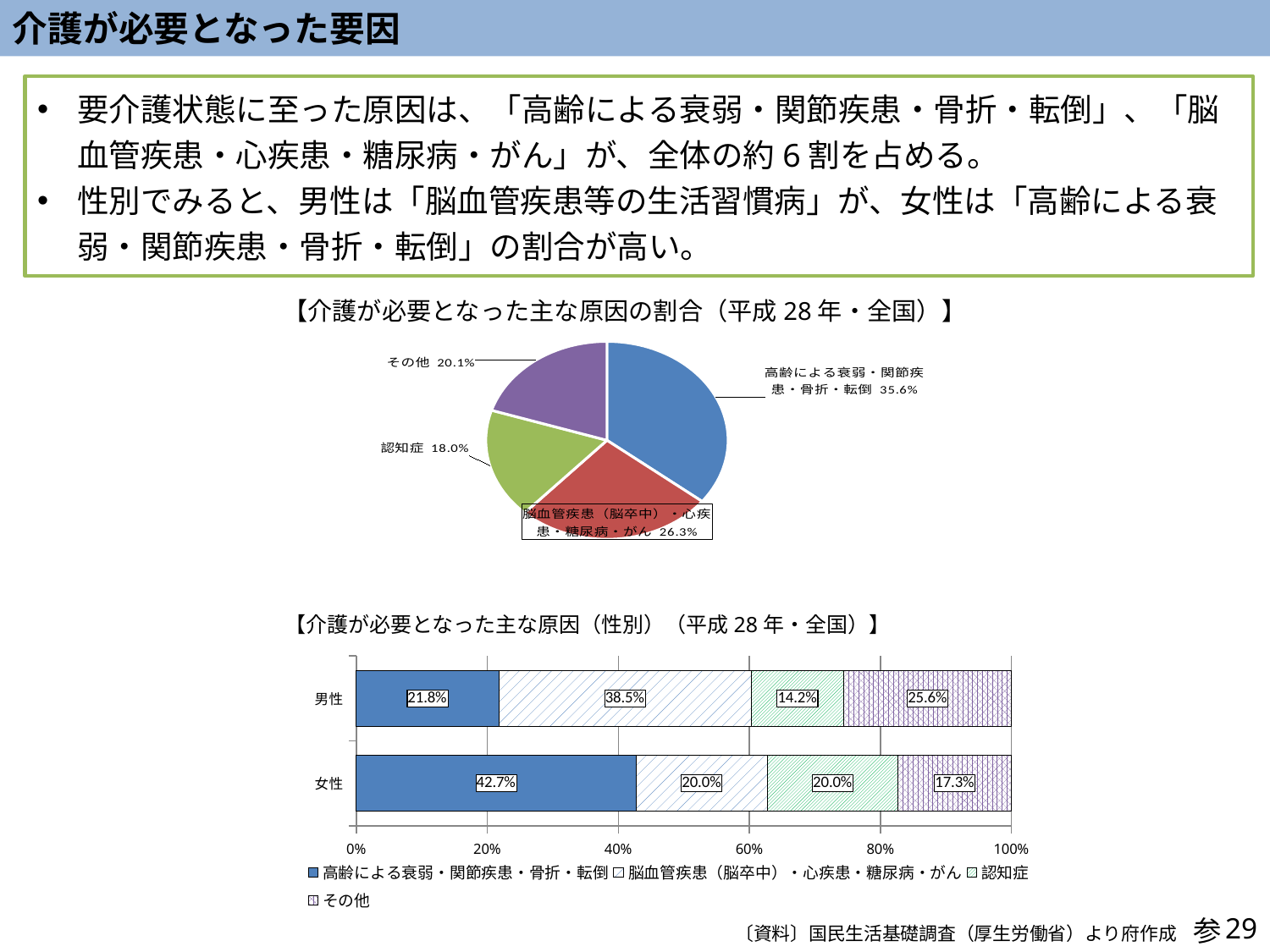
下のグラフ【介護が必要となった主な原因（性別）（平成28年・全国）】で、「認知症」の割合は男性と女性のどちらが大きいですか？ 女性 上の円グラフ【介護が必要となった主な原因の割合（平成28年・全国）】には、いくつの区分がありますか？ 4 下のグラフ【介護が必要となった主な原因（性別）（平成28年・全国）】は、どの種類のグラフですか？ 積み上げ棒グラフ 上の円グラフ【介護が必要となった主な原因の割合（平成28年・全国）】で、最も割合が大きい原因はどれですか？ 高齢による衰弱・関節疾患・骨折・転倒 下のグラフ【介護が必要となった主な原因（性別）（平成28年・全国）】で、「その他」の割合の男性と女性の差はいくつですか？ 8.3% 上の円グラフ【介護が必要となった主な原因の割合（平成28年・全国）】で、「脳血管疾患（脳卒中）・心疾患・糖尿病・がん」と「その他」の割合の差はいくつですか？ 6.2% 下のグラフ【介護が必要となった主な原因（性別）（平成28年・全国）】の凡例には、いくつの系列がありますか？ 4 下のグラフ【介護が必要となった主な原因（性別）（平成28年・全国）】で、女性の「高齢による衰弱・関節疾患・骨折・転倒」の割合はいくつですか？ 42.7% 上の円グラフ【介護が必要となった主な原因の割合（平成28年・全国）】で、「高齢による衰弱・関節疾患・骨折・転倒」の割合はいくつですか？ 35.6% 上の円グラフ【介護が必要となった主な原因の割合（平成28年・全国）】で、「認知症」の割合はいくつですか？ 18.0% 下のグラフ【介護が必要となった主な原因（性別）（平成28年・全国）】で、男性の「脳血管疾患（脳卒中）・心疾患・糖尿病・がん」の割合はいくつですか？ 38.5% 上の円グラフ【介護が必要となった主な原因の割合（平成28年・全国）】で、最も割合が小さい原因はどれですか？ 認知症